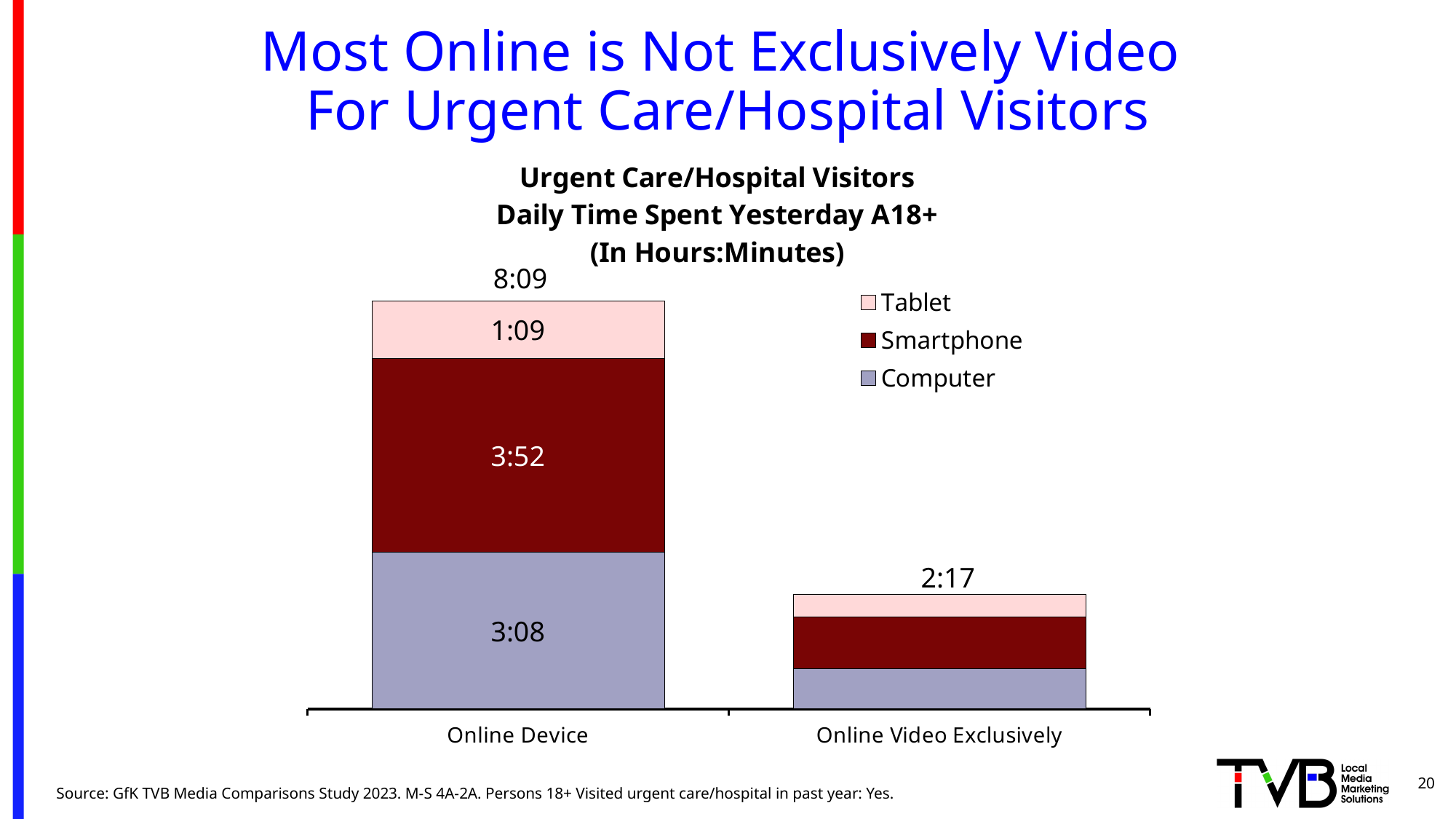
What is the total daily time spent for Online Video Exclusively? 2:17 What is the difference between the Online Device total and the Online Video Exclusively total? 5:52 How much time is spent on Smartphone in the Online Device bar? 3:52 What is the total daily time spent for Online Device? 8:09 How many series does the legend list? 3 How much time is spent on Tablet in the Online Device bar? 1:09 Which device segment is the smallest in the Online Device bar? Tablet How much time is spent on Computer in the Online Device bar? 3:08 What kind of chart is shown on the slide? Stacked bar chart Which device segment is the largest in the Online Device bar? Smartphone How many categories are shown on the x axis? 2 Which category has the larger total, Online Device or Online Video Exclusively? Online Device